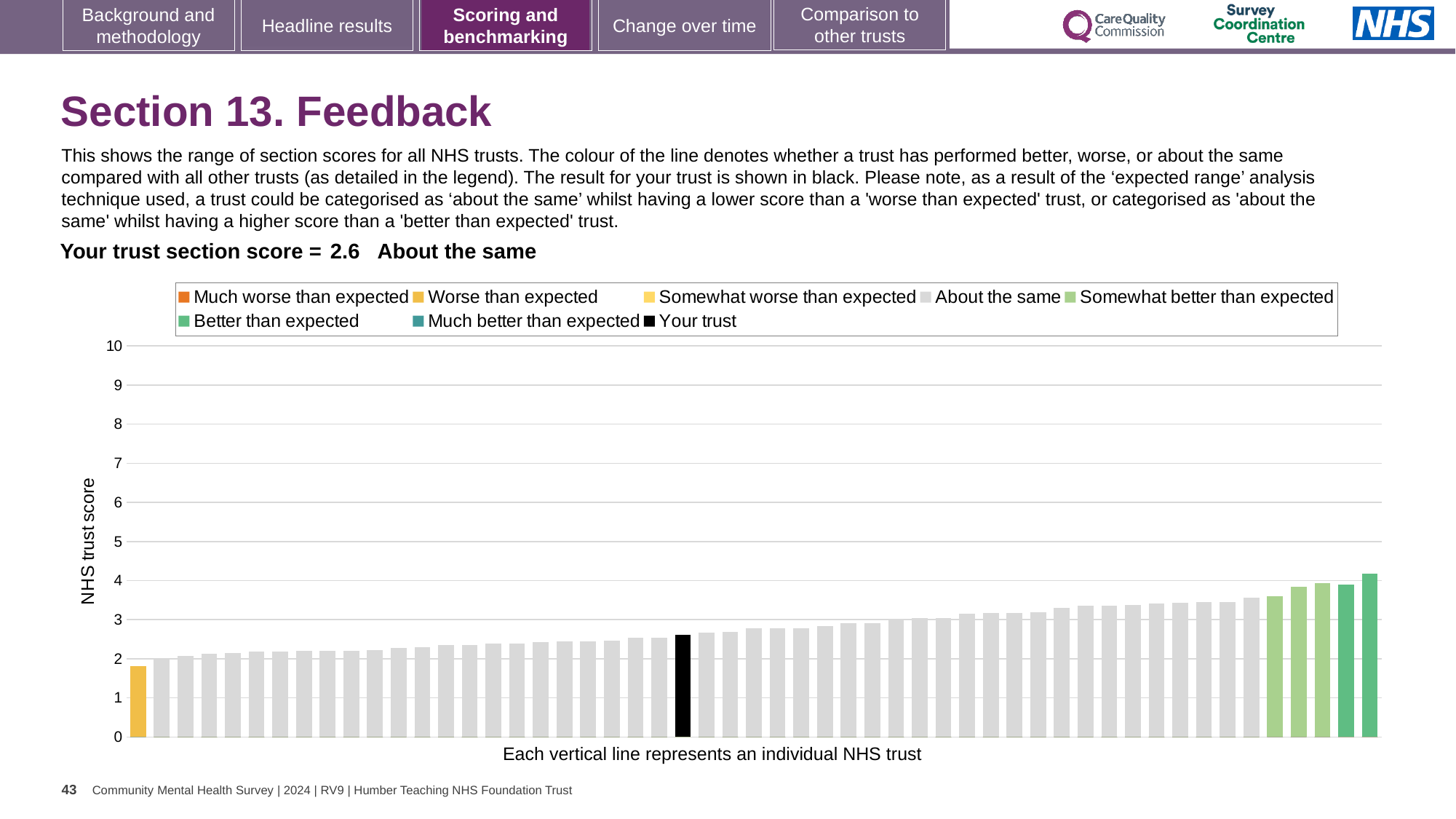
Is the value for your trust greater or less than 2? greater Which performance category is your trust placed in for Section 13? About the same Which legend category does the lowest-scoring trust (the leftmost bar) belong to? Worse than expected Is the value for the lowest-scoring trust (the leftmost bar) greater or less than 2? less Is the value for your trust greater or less than 3? less What kind of chart is shown on the slide? bar chart What colour is the bar representing your trust? black Do the trust scores rise or fall moving from left to right along the x axis? rise What is the section score for your trust shown on the slide? 2.6 How many entries does the chart legend list? 8 What is the label on the vertical axis of the chart? NHS trust score